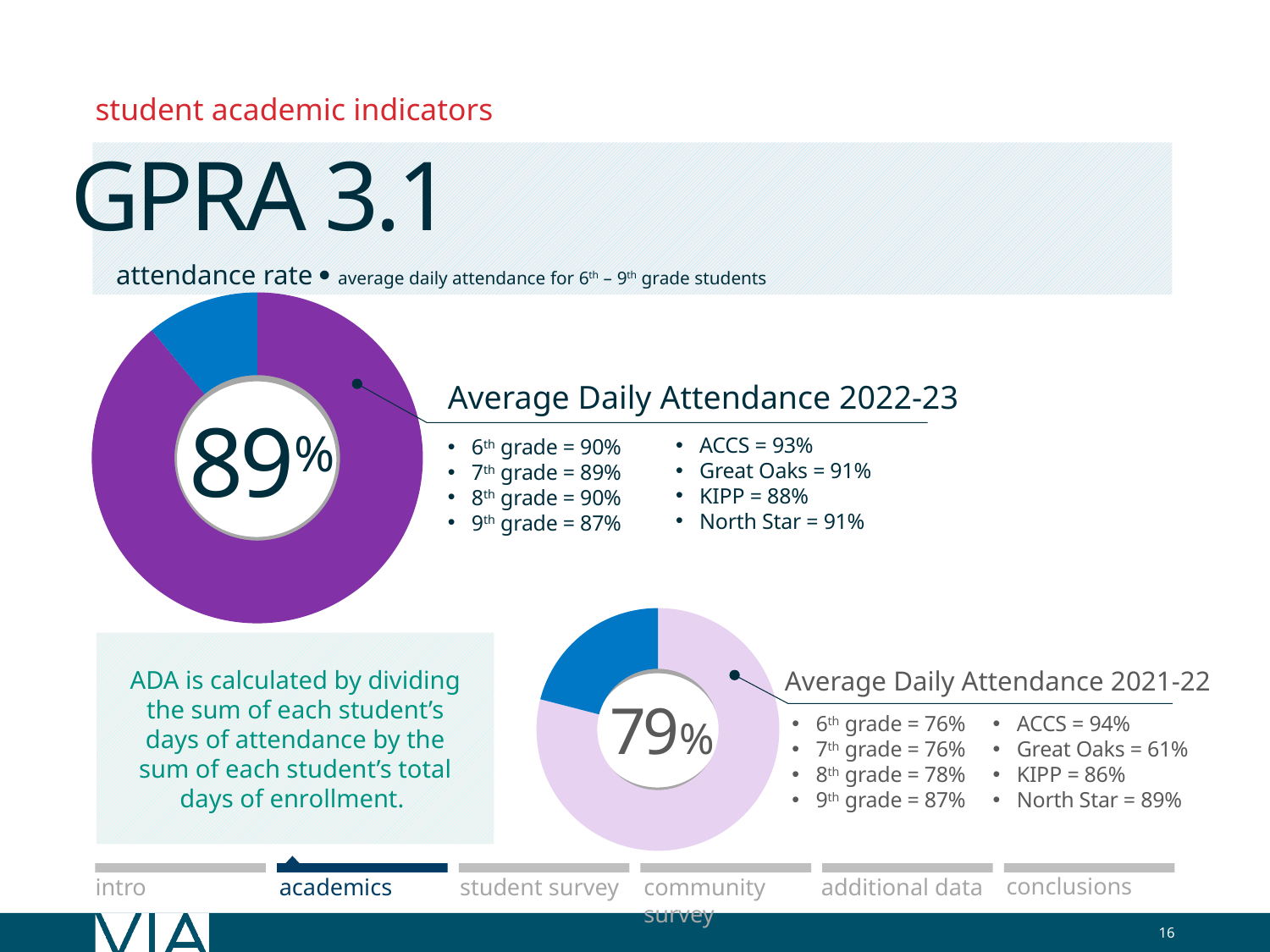
Which donut chart shows the larger attendance rate, Average Daily Attendance 2022-23 or Average Daily Attendance 2021-22? Average Daily Attendance 2022-23 What value is shown in the center of the Average Daily Attendance 2021-22 donut chart? 79% What value is shown in the center of the Average Daily Attendance 2022-23 donut chart? 89% What colour is the filled portion of the Average Daily Attendance 2022-23 donut chart? Purple In the Average Daily Attendance 2022-23 chart, which school has the highest attendance rate? ACCS In the Average Daily Attendance 2021-22 chart, which school has the lowest attendance rate? Great Oaks How many donut charts are on the slide? 2 What kind of chart is used to show the Average Daily Attendance 2022-23 value? Donut chart In the Average Daily Attendance 2021-22 chart, what is the difference between the 9th grade rate and the 6th grade rate? 11% In the Average Daily Attendance 2021-22 chart, what is the attendance rate for KIPP? 86% In the Average Daily Attendance 2022-23 chart, what is the attendance rate for 9th grade? 87% What is the difference between the Average Daily Attendance 2022-23 donut value and the Average Daily Attendance 2021-22 donut value? 10%